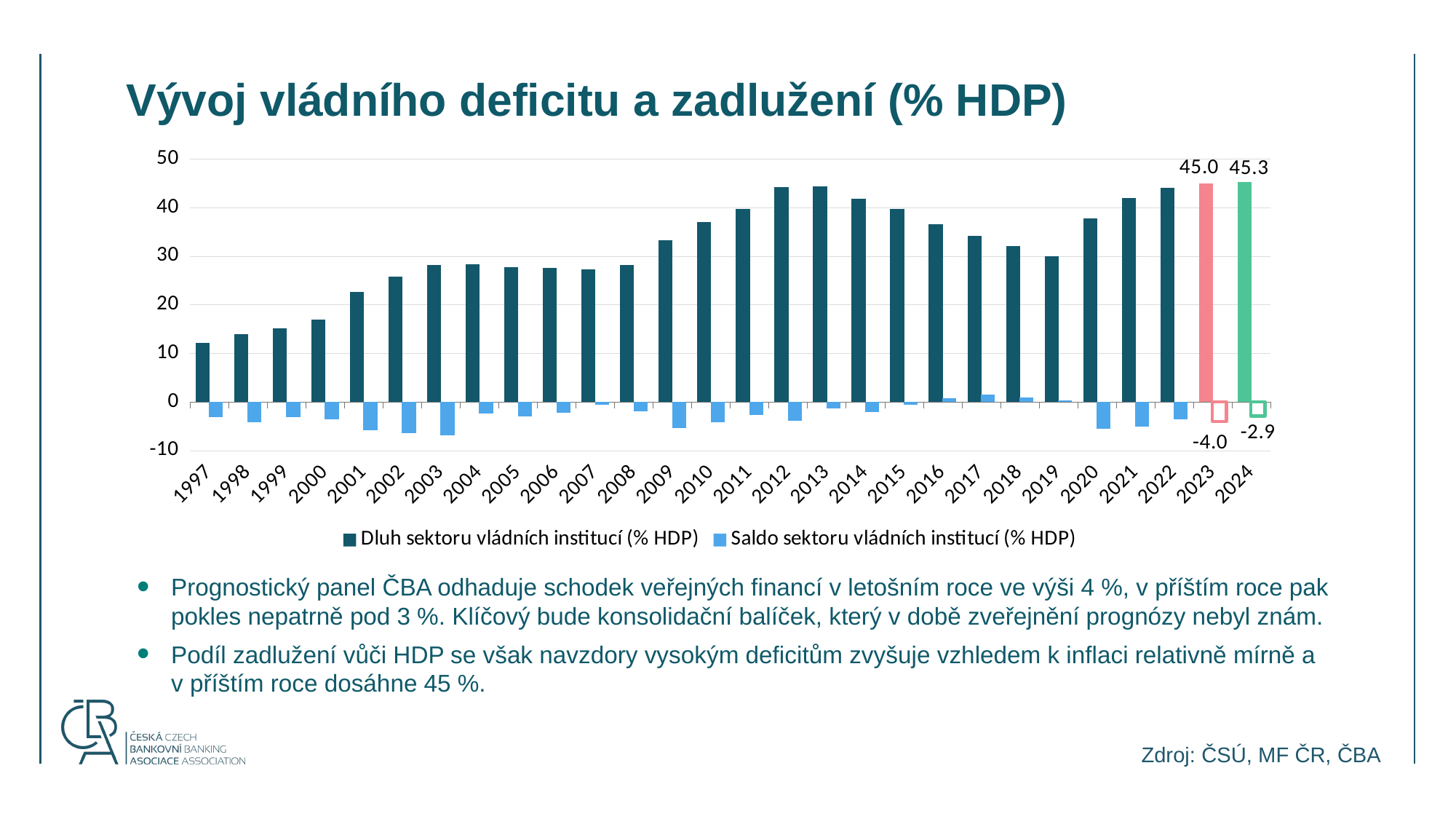
What is the value of Saldo sektoru vládních institucí (% HDP) for 2024? -2.9 Which year has a higher debt (Dluh) value, 2023 or 2024? 2024 What is the value of Dluh sektoru vládních institucí (% HDP) for 2024? 45.3 How many years are shown on the x axis? 28 Is the debt (Dluh) value for 2019 greater or less than 40? less What is the value of Dluh sektoru vládních institucí (% HDP) for 2023? 45.0 How many series does the legend list? 2 What is the value of Saldo sektoru vládních institucí (% HDP) for 2023? -4.0 Is the debt (Dluh) value for 2012 greater or less than 40? greater By how much does the debt (Dluh) value for 2024 exceed the value for 2023? 0.3 Which year has the lowest debt (Dluh sektoru vládních institucí) value? 1997 What kind of chart is shown on the slide? Bar chart